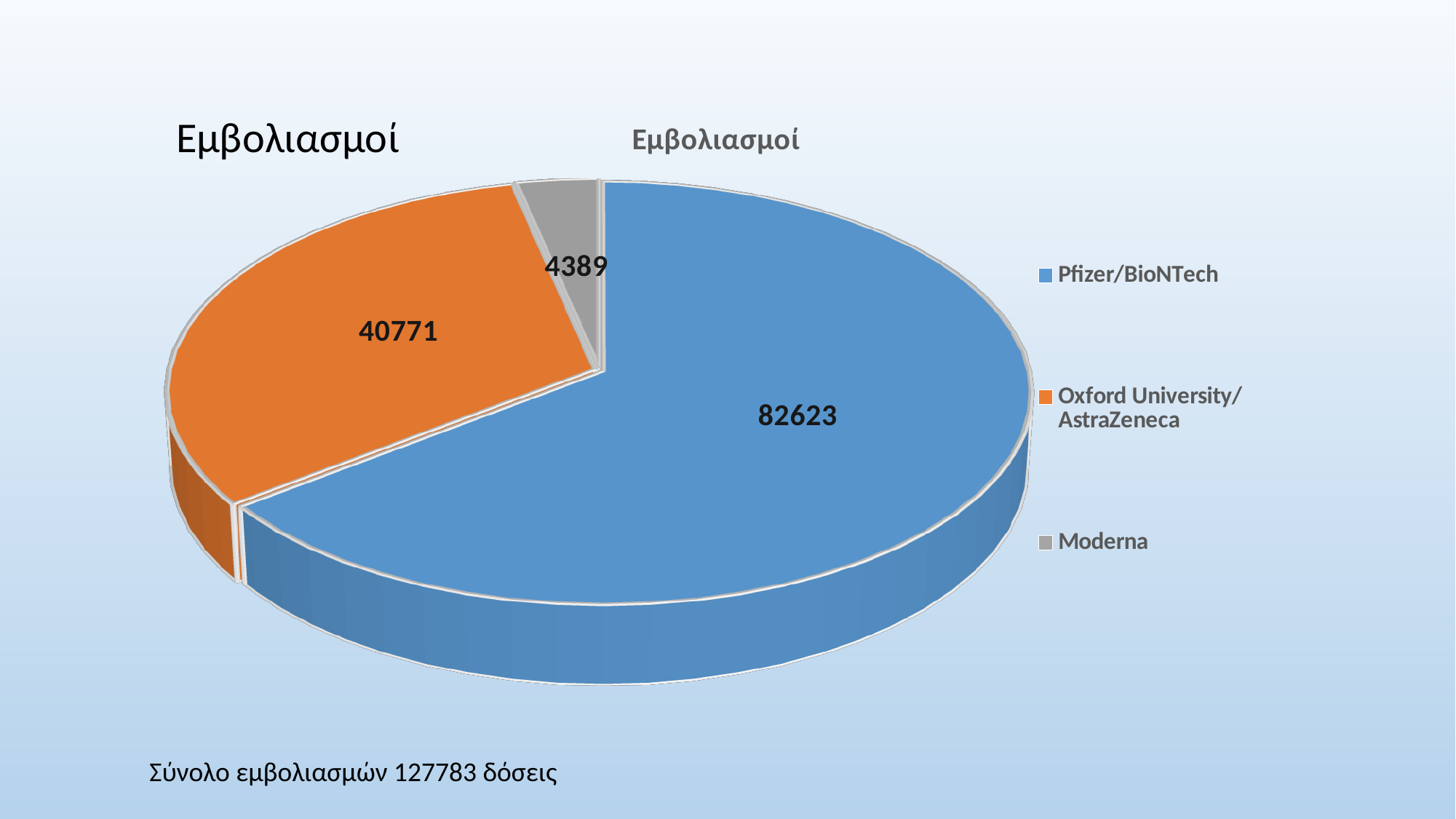
Which colour represents Moderna in the pie chart? Grey What is the value for Moderna? 4389 What is the value for Oxford University/AstraZeneca? 40771 What is the value for Pfizer/BioNTech? 82623 What is the title of the chart? Εμβολιασμοί What is the difference between the Pfizer/BioNTech value and the Oxford University/AstraZeneca value? 41852 What is the total of all three slices in the pie chart? 127783 Which vaccine has the largest slice of the pie? Pfizer/BioNTech What kind of chart is shown on the slide? Pie chart Which vaccine has the smallest slice of the pie? Moderna How many slices does the pie chart have? 3 Which is larger, the value for Oxford University/AstraZeneca or the value for Moderna? Oxford University/AstraZeneca